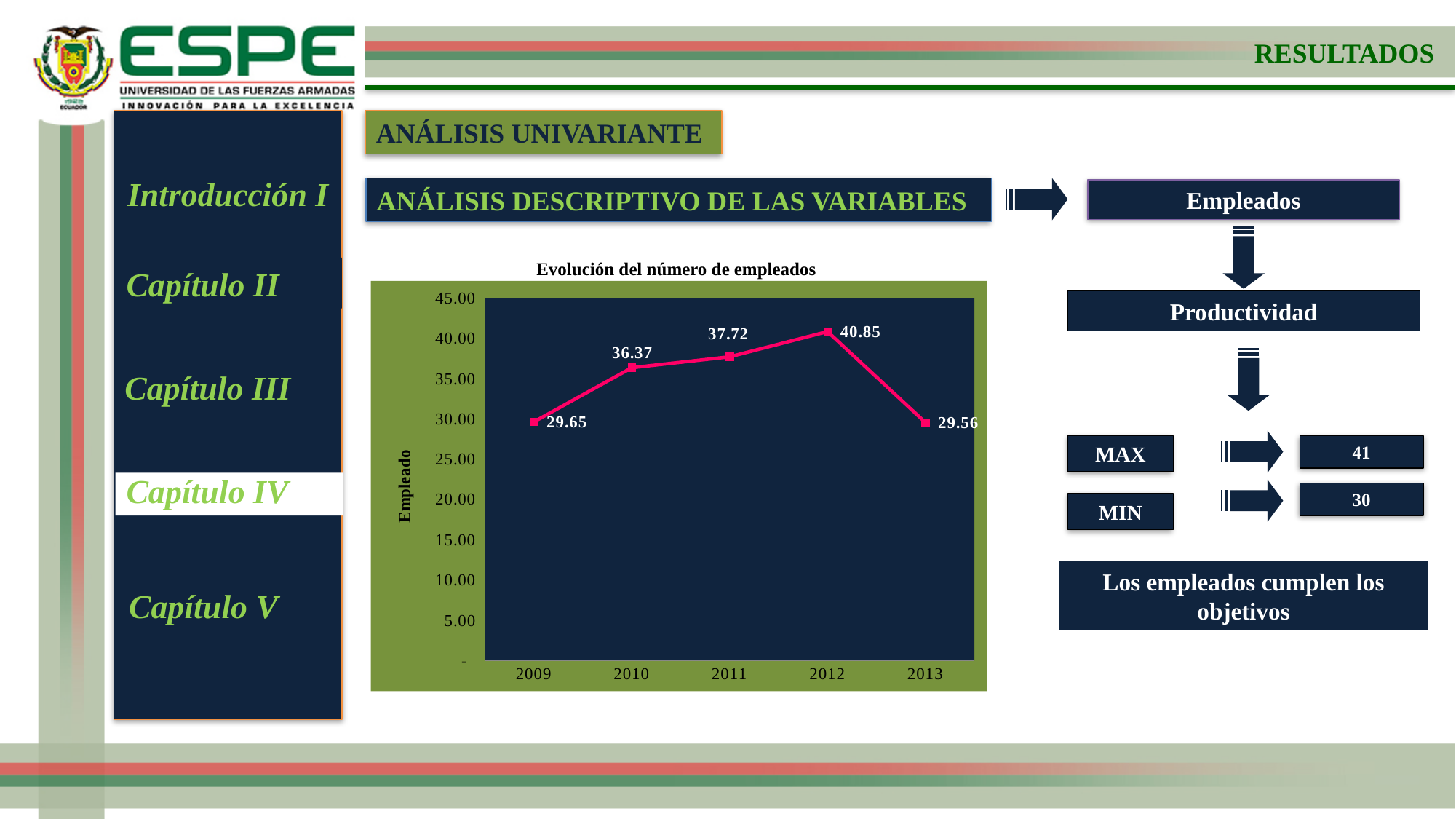
What is the difference between the values for 2010 and 2009? 6.72 What is the difference between the values for 2012 and 2013? 11.29 What is the value for 2012 in the chart? 40.85 Is the value for 2012 greater or less than 40.00? greater What kind of chart is shown on the slide? line chart Which is larger, the value for 2010 or the value for 2011? 2011 Which year has the lowest value in the chart? 2013 What is the value for 2009 in the chart? 29.65 How many years are plotted on the x axis of the chart? 5 What is the title of the chart? Evolución del número de empleados What is the value for 2011 in the chart? 37.72 Which year has the highest value in the chart? 2012